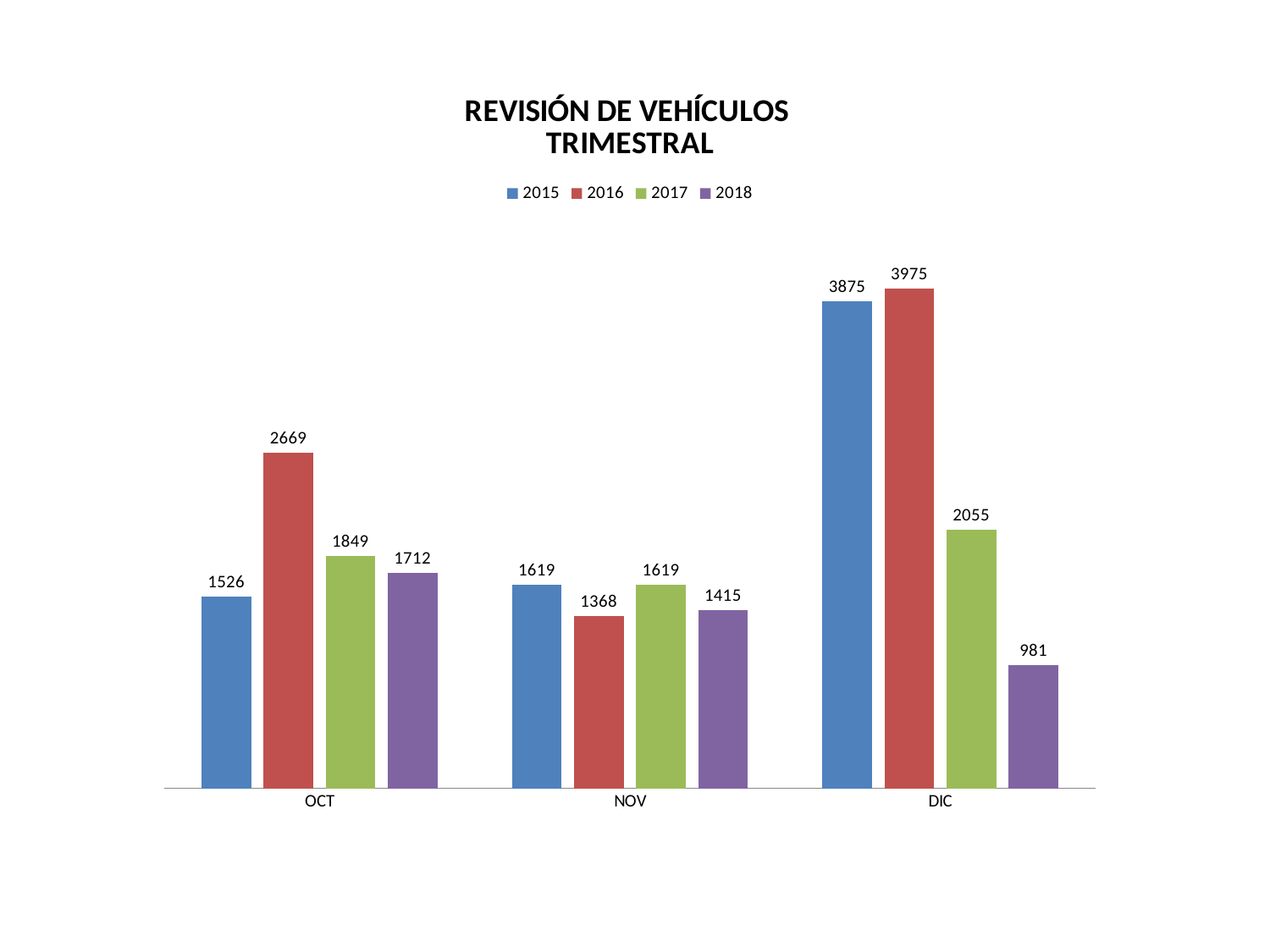
What is the value for 2017 in NOV? 1619 What is the difference between the 2017 and 2018 values in OCT? 137 Which is larger: the 2015 value in OCT or the 2015 value in NOV? NOV What is the value for 2016 in OCT? 2669 What is the difference between the 2016 and 2015 values in DIC? 100 Which year has the highest value in DIC? 2016 What kind of chart is this? bar chart What is the title of the chart? REVISIÓN DE VEHÍCULOS TRIMESTRAL How many series does the legend list? 4 What is the value for 2018 in DIC? 981 How many months are shown on the x axis? 3 Which year has the lowest value in NOV? 2016